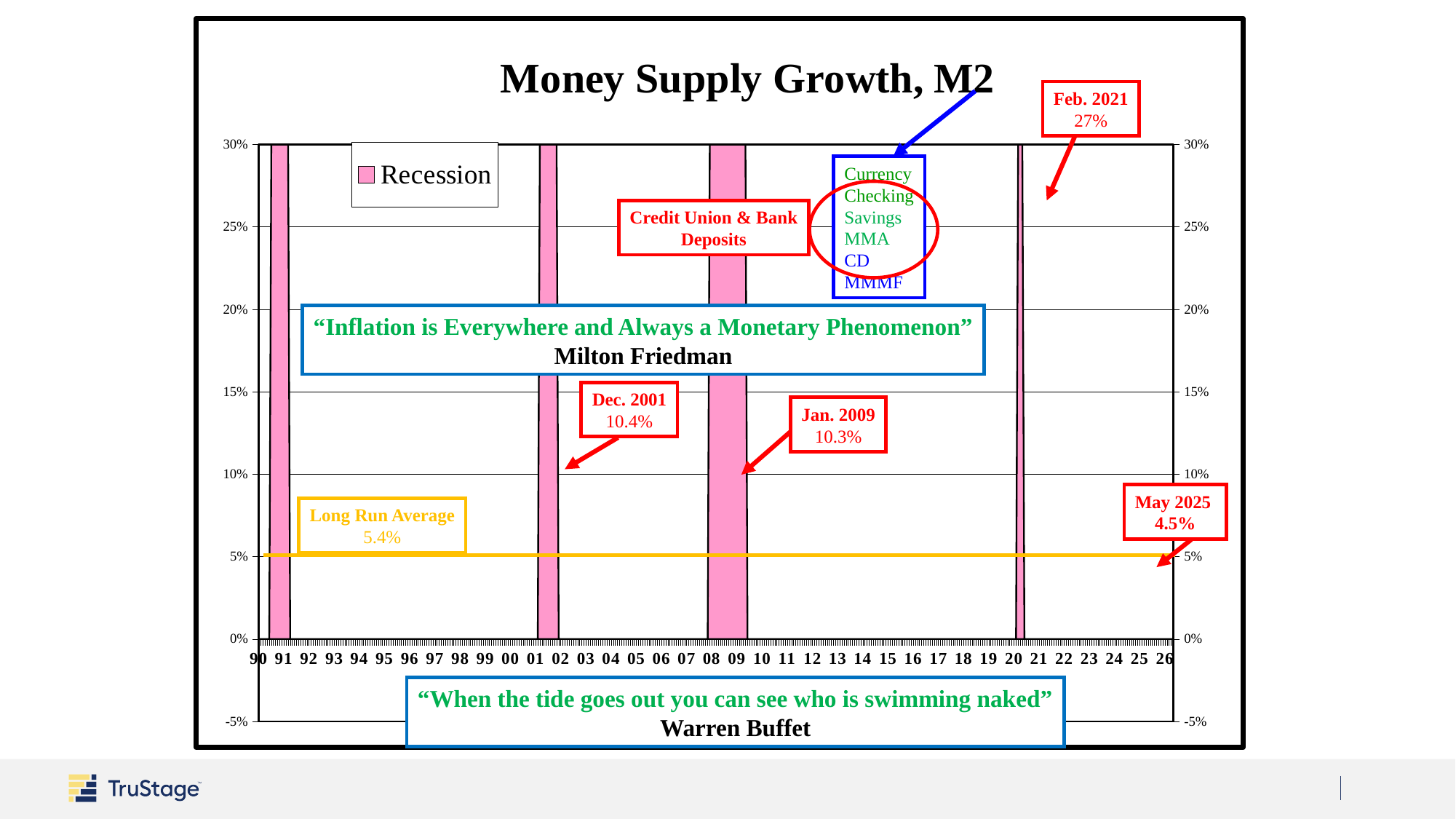
What M2 growth value is annotated for Dec. 2001? 10.4% What M2 growth value is annotated for Feb. 2021? 27% Which is larger, the annotated value for Dec. 2001 or for Jan. 2009? Dec. 2001 How many pink recession bars are shaded on the chart? 4 Which annotated date has the highest M2 growth value? Feb. 2021 What entry does the chart's legend list? Recession Which annotated date has the lowest M2 growth value? May 2025 What M2 growth value is annotated for May 2025? 4.5% What is the difference between the Feb. 2021 value and the Dec. 2001 value? 16.6 percentage points What is the Long Run Average value shown on the chart? 5.4% What M2 growth value is annotated for Jan. 2009? 10.3% What is the title of the chart? Money Supply Growth, M2